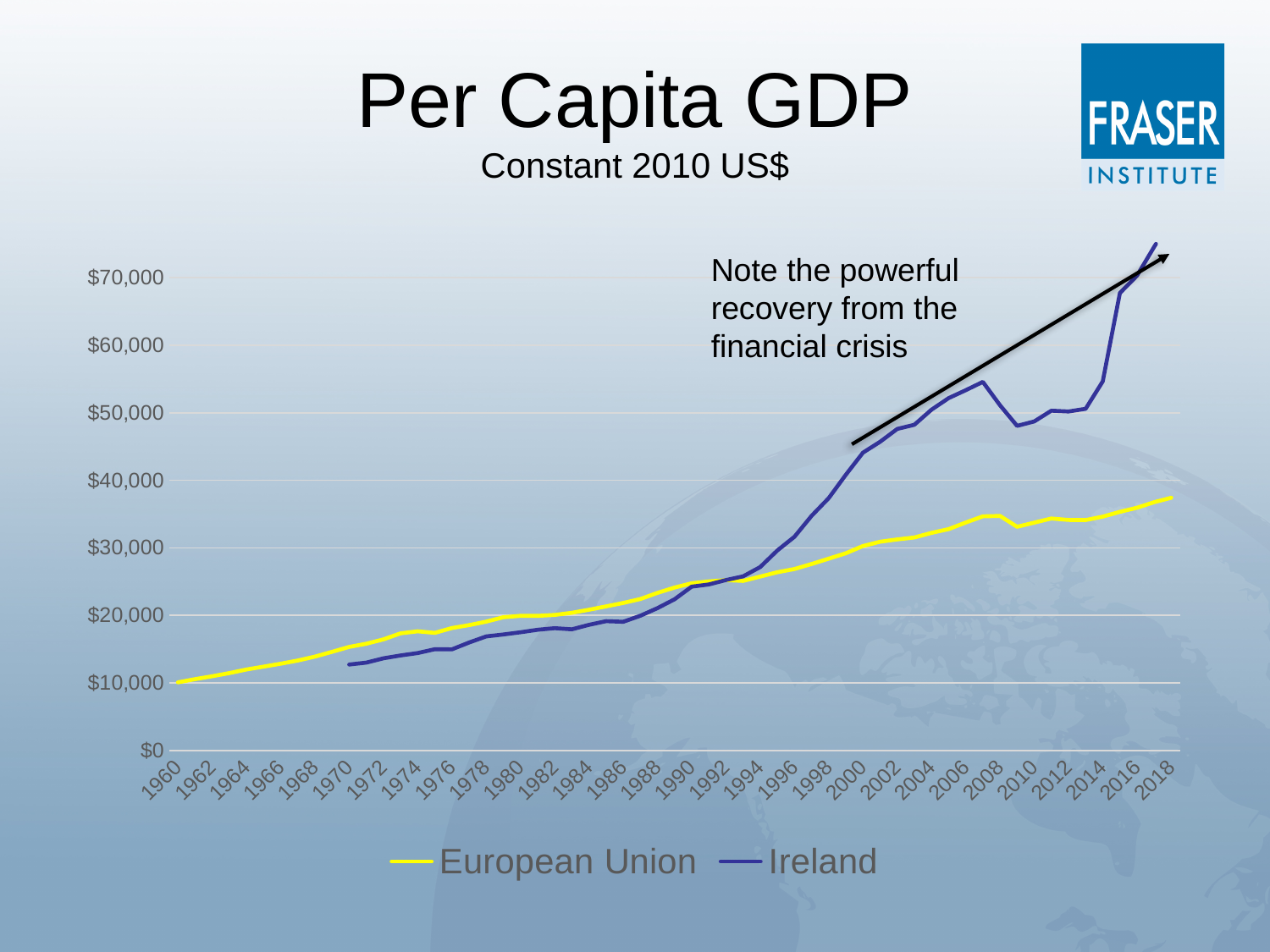
What kind of chart is shown on the slide? Line chart Does the European Union line generally rise or fall from 1960 to 2018? Rise Is the value for Ireland in 2016 greater or less than $60,000? greater Which series has the higher value in 2018, European Union or Ireland? Ireland Does the Ireland line rise or fall between 2008 and 2010? Fall Is the value for the European Union in 2000 greater or less than $20,000? greater Is the value for the European Union in 2018 greater or less than $40,000? less Which series has the higher value in 1970, European Union or Ireland? European Union What is the title of the chart? Per Capita GDP How many series does the legend list? 2 Which two series are shown in the legend? European Union and Ireland